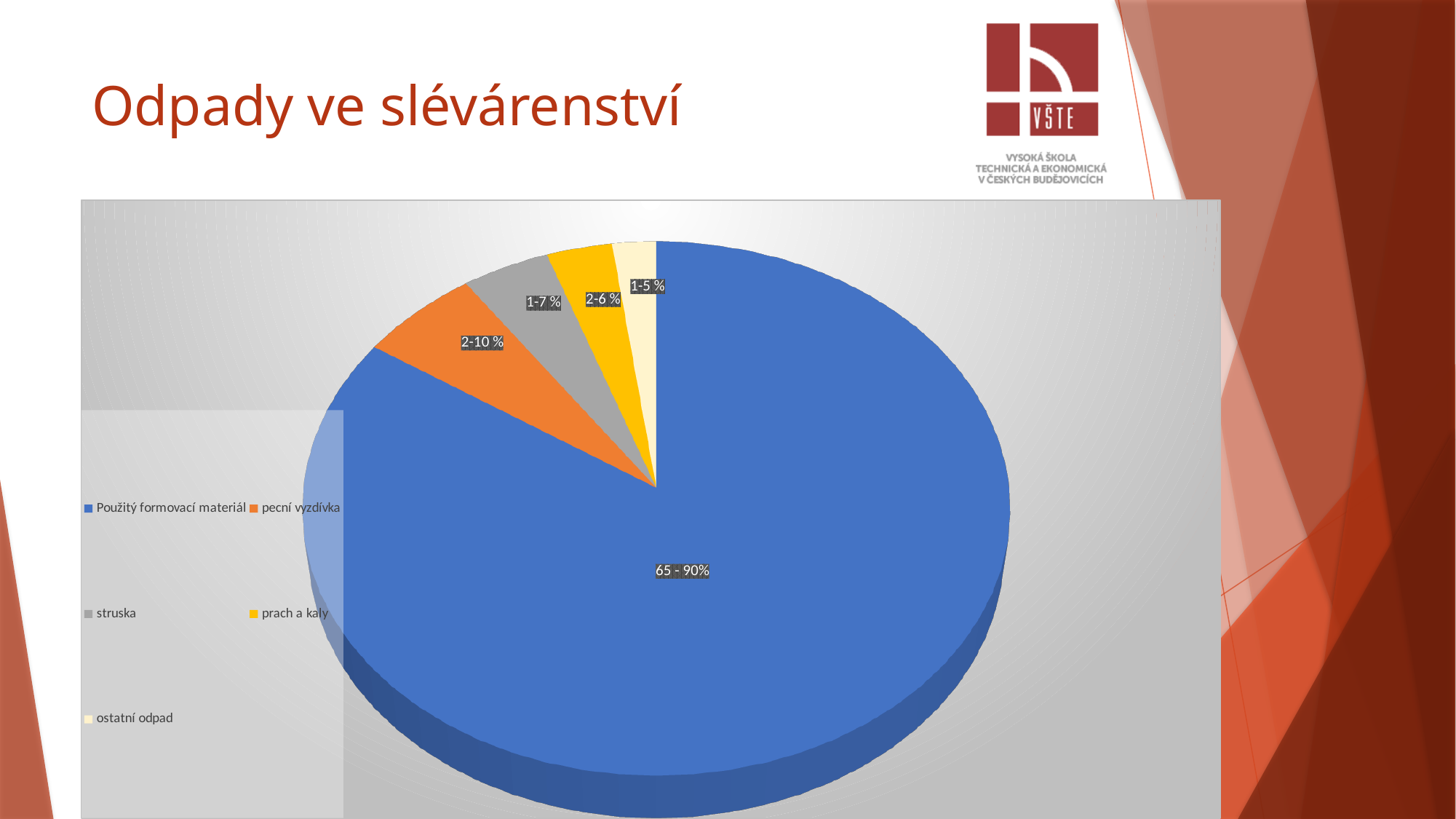
How many slices does the pie chart have? 5 What is the data label shown on the slice for struska? 1-7 % How many entries does the legend of the pie chart list? 5 Which slice is larger, pecní vyzdívka or struska? pecní vyzdívka Which slice is larger, Použitý formovací materiál or pecní vyzdívka? Použitý formovací materiál What colour is the slice for prach a kaly in the pie chart? yellow What is the data label shown on the slice for Použitý formovací materiál? 65 - 90% What is the data label shown on the slice for pecní vyzdívka? 2-10 % What is the data label shown on the slice for prach a kaly? 2-6 % What is the data label shown on the slice for ostatní odpad? 1-5 % What kind of chart is shown on the slide? pie chart Which category has the largest slice of the pie chart? Použitý formovací materiál